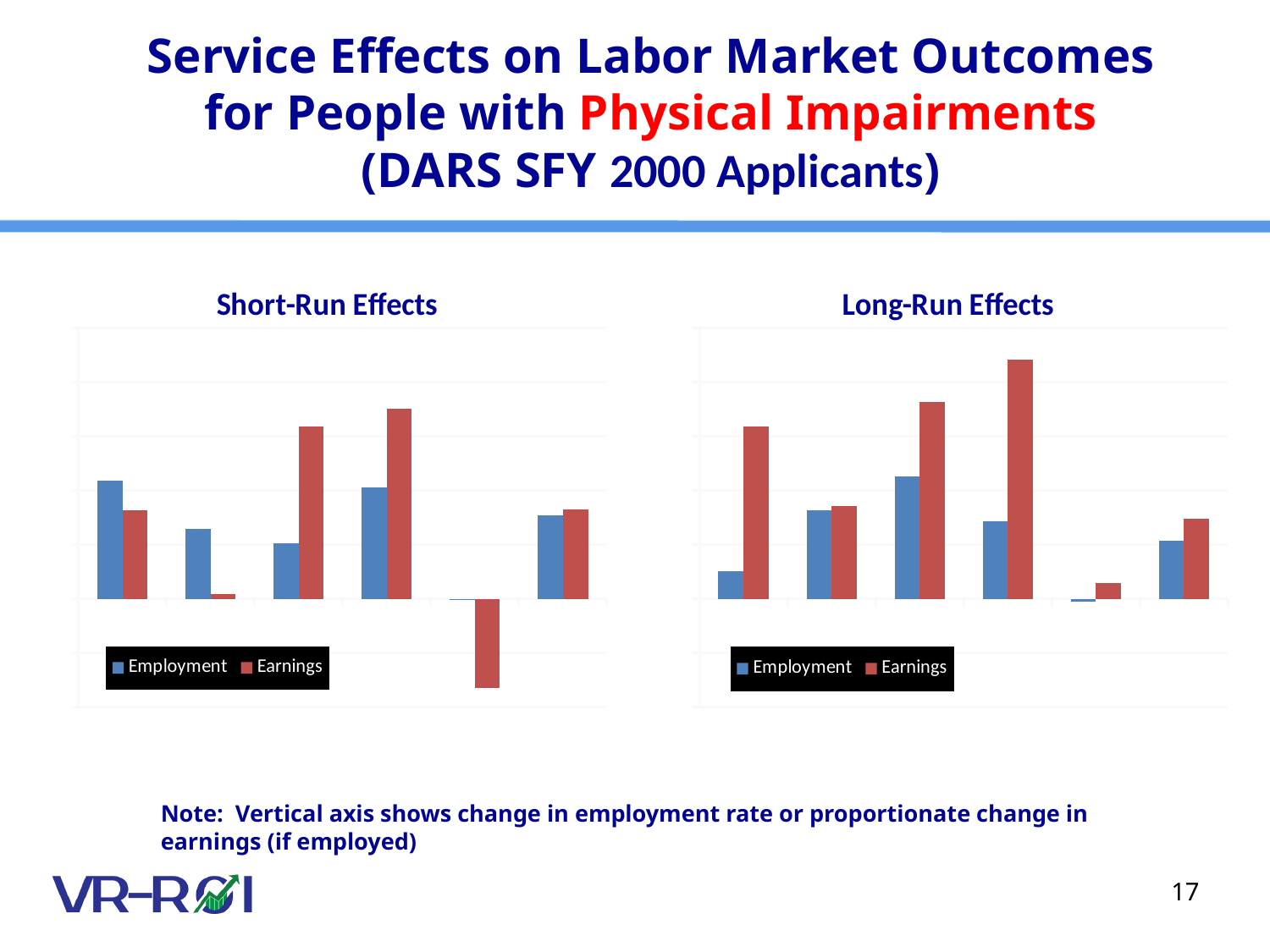
What are the two series named in the legend of the Short-Run Effects chart? Employment and Earnings How many groups of bars are plotted in the Long-Run Effects chart? 6 What kind of chart is the Short-Run Effects chart? bar chart What is the title of the chart on the left side of the slide? Short-Run Effects How many series does the legend of the Long-Run Effects chart list? 2 In the Short-Run Effects chart, is the Earnings bar in the fifth group from the left positive or negative? negative In the Short-Run Effects chart, in the first group from the left, which bar is taller: Employment or Earnings? Employment In the Long-Run Effects chart, which group from the left has the tallest Earnings bar? the fourth group How many groups of bars are plotted in the Short-Run Effects chart? 6 In the Short-Run Effects chart, which group from the left has the tallest Earnings bar? the fourth group In the Long-Run Effects chart, which group from the left has the tallest Employment bar? the third group In the Long-Run Effects chart, in the first group from the left, which bar is taller: Employment or Earnings? Earnings